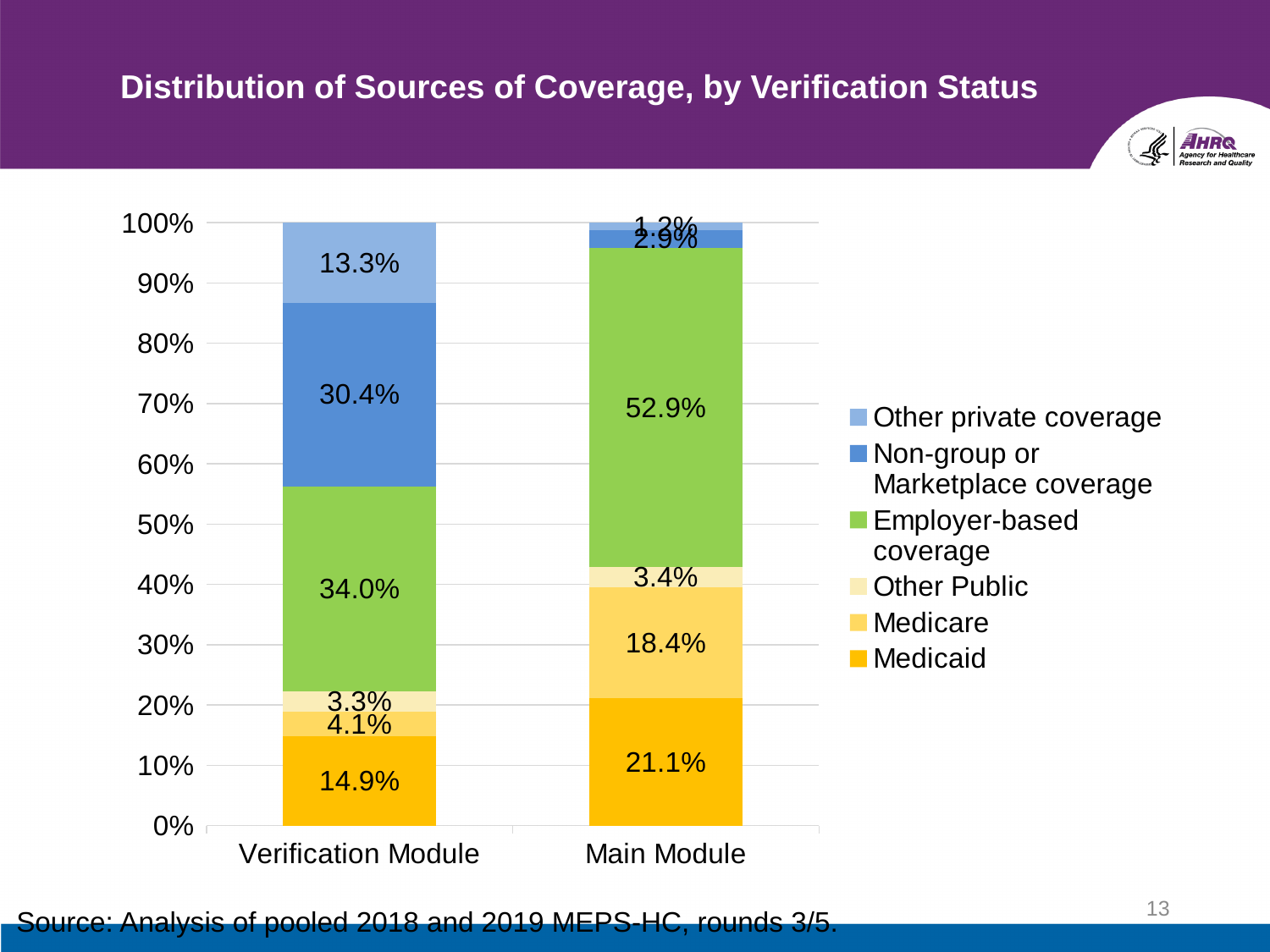
What is the title of the chart? Distribution of Sources of Coverage, by Verification Status What is the Medicare share for the Main Module? 18.4% Which is larger: the Medicare share in the Verification Module or in the Main Module? Main Module Which source of coverage has the smallest share in the Verification Module bar? Other Public What is the Medicaid share for the Verification Module? 14.9% How many series does the legend list? 6 How many categories are shown on the x axis? 2 Which source of coverage has the largest share in the Main Module bar? Employer-based coverage What is the Employer-based coverage share for the Main Module? 52.9% What kind of chart is shown on the slide? Stacked bar chart What is the Non-group or Marketplace coverage share for the Verification Module? 30.4% What is the difference between the Medicaid share in the Main Module and in the Verification Module? 6.2%